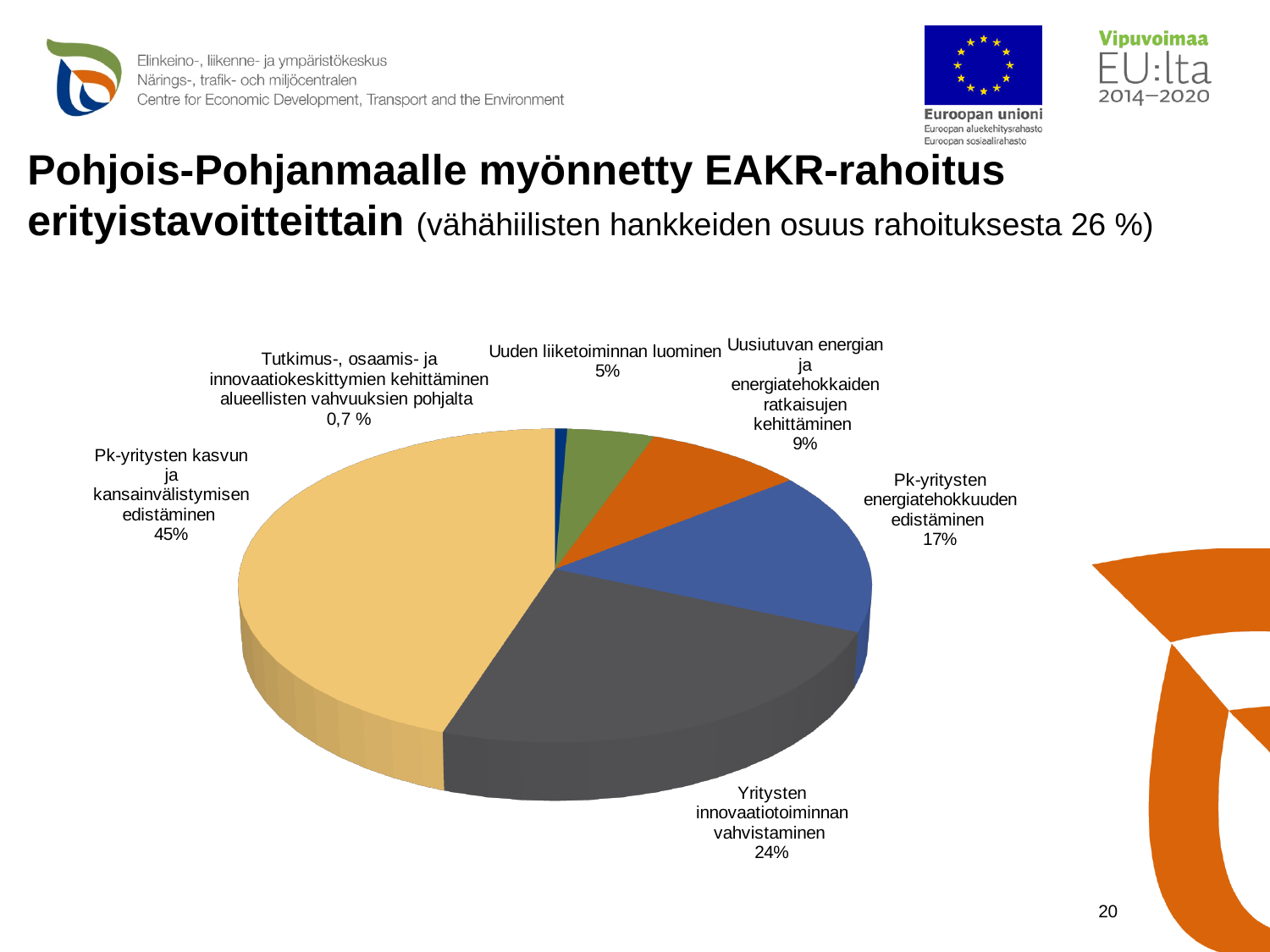
What share of the funding goes to 'Pk-yritysten energiatehokkuuden edistäminen'? 17% What colour is the slice for 'Yritysten innovaatiotoiminnan vahvistaminen'? Dark grey What share of the funding goes to 'Yritysten innovaatiotoiminnan vahvistaminen'? 24% Which category has the smallest share of the pie? Tutkimus-, osaamis- ja innovaatiokeskittymien kehittäminen alueellisten vahvuuksien pohjalta What share of the funding goes to 'Uuden liiketoiminnan luominen'? 5% Which has a larger share: 'Pk-yritysten energiatehokkuuden edistäminen' or 'Uusiutuvan energian ja energiatehokkaiden ratkaisujen kehittäminen'? Pk-yritysten energiatehokkuuden edistäminen What share of the funding goes to 'Uusiutuvan energian ja energiatehokkaiden ratkaisujen kehittäminen'? 9% What share of the funding goes to 'Pk-yritysten kasvun ja kansainvälistymisen edistäminen'? 45% What kind of chart is shown on the slide? Pie chart How many slices does the pie chart have? 6 Which category has the largest share of the pie? Pk-yritysten kasvun ja kansainvälistymisen edistäminen What is the difference in percentage points between 'Pk-yritysten kasvun ja kansainvälistymisen edistäminen' and 'Yritysten innovaatiotoiminnan vahvistaminen'? 21 percentage points